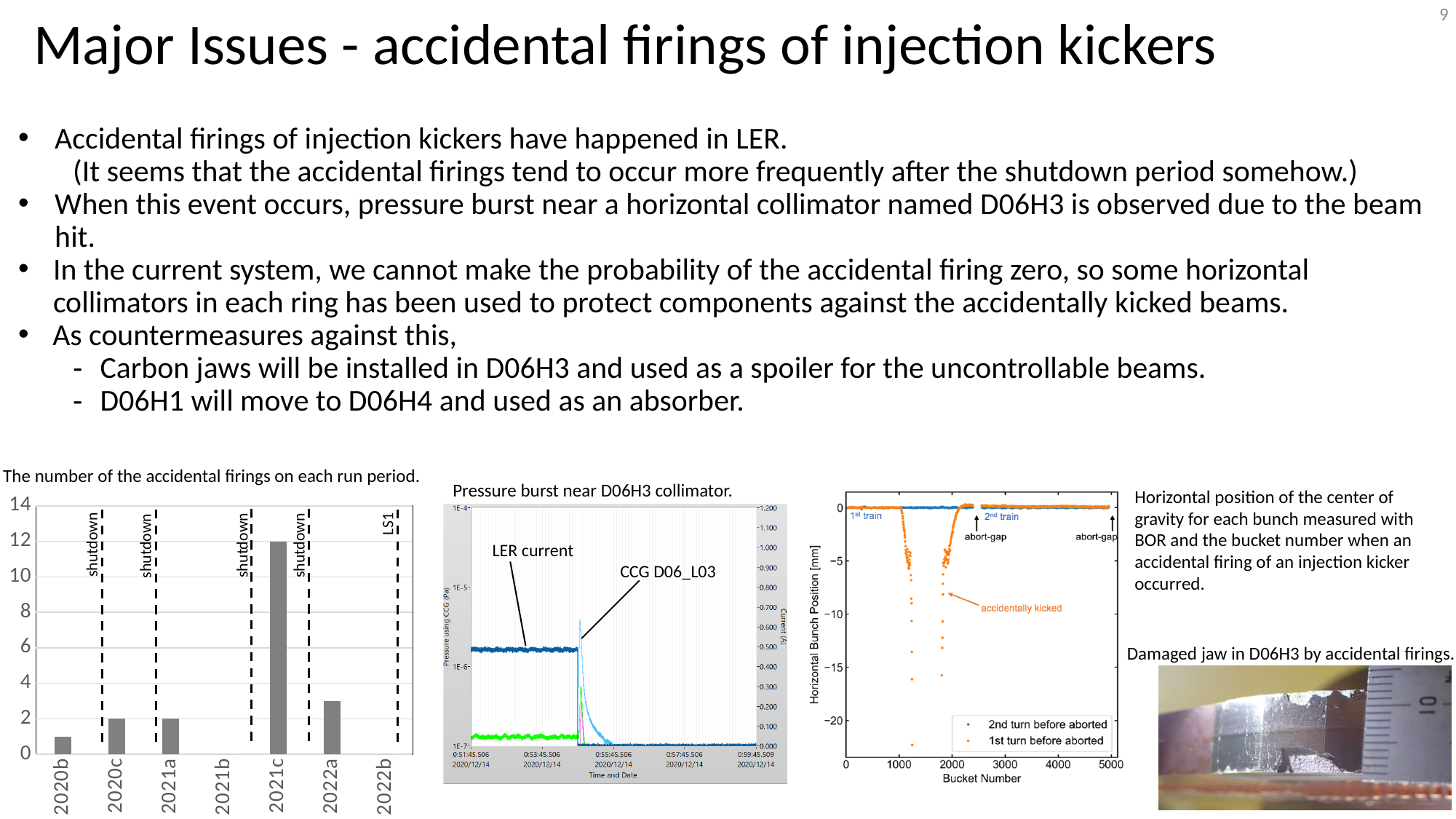
In the chart of the number of accidental firings on each run period, which is larger, the value for 2022a or the value for 2020b? 2022a In the scatter plot of horizontal bunch position versus bucket number, how many series does the legend list? 2 In the chart of the number of accidental firings on each run period, how many run periods are shown on the x axis? 7 In the chart of the number of accidental firings on each run period, what is the number of accidental firings for 2021a? 2 In the chart of the number of accidental firings on each run period, is the value for 2020b greater or less than 2? less In the chart of the number of accidental firings on each run period, which run period has the highest number of accidental firings? 2021c In the chart of the number of accidental firings on each run period, what is the number of accidental firings for 2020c? 2 In the chart of the number of accidental firings on each run period, what kind of chart is it? bar chart In the chart of the number of accidental firings on each run period, what is the difference between the values for 2021c and 2020c? 10 In the pressure burst chart near the D06H3 collimator, what is the label of the x axis? Time and Date In the chart of the number of accidental firings on each run period, is the value for 2022a greater or less than 4? less In the chart of the number of accidental firings on each run period, what is the number of accidental firings for 2021c? 12